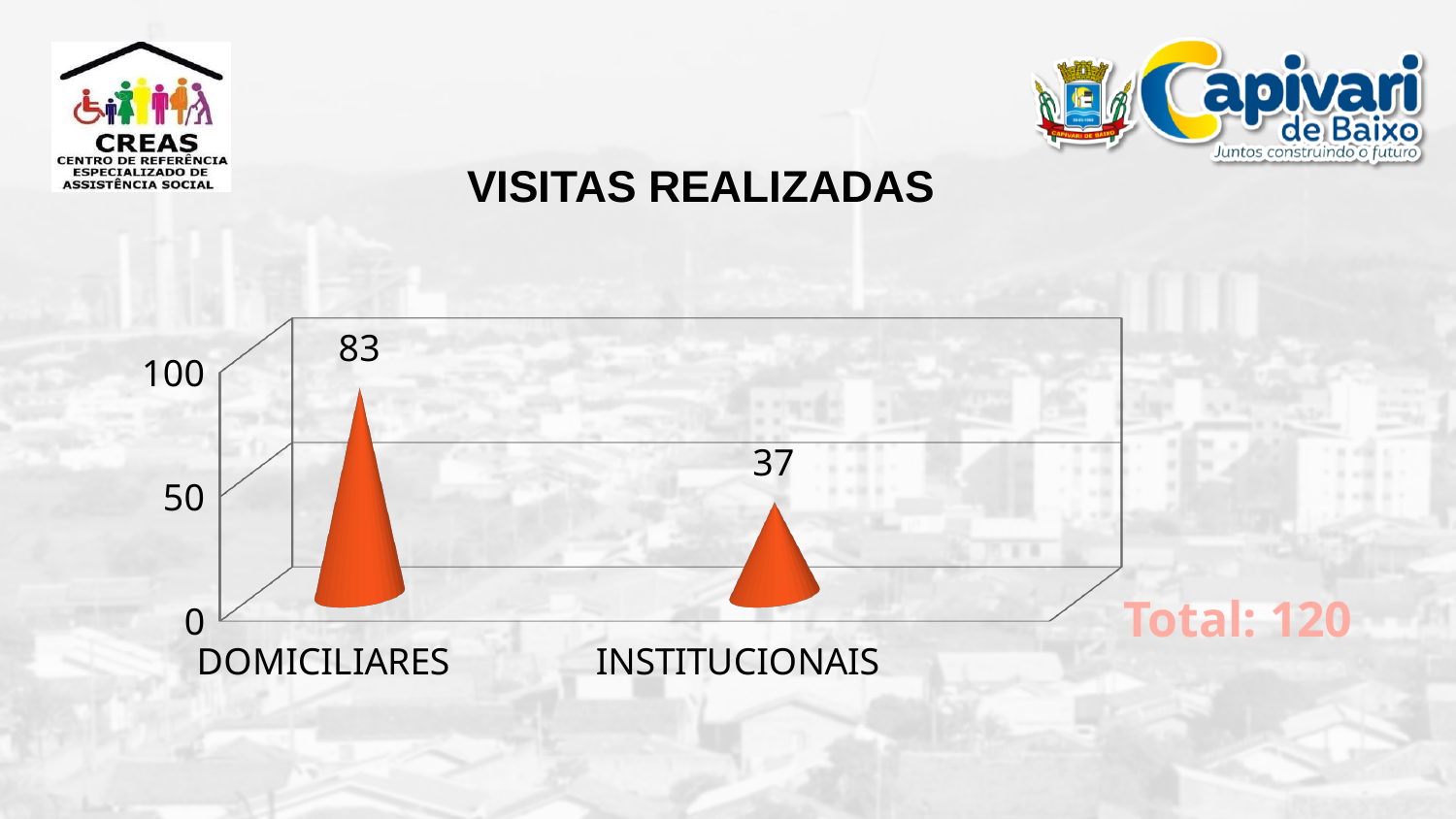
What is the title of the chart? VISITAS REALIZADAS What is the value for INSTITUCIONAIS? 37 What is the difference between the values for DOMICILIARES and INSTITUCIONAIS? 46 Is the value for DOMICILIARES greater or less than 50? greater Which category has the highest value? DOMICILIARES Is the value for INSTITUCIONAIS greater or less than 50? less Which category has the lowest value? INSTITUCIONAIS Which is larger, the value for DOMICILIARES or the value for INSTITUCIONAIS? DOMICILIARES How many categories are shown in the chart? 2 What is the value for DOMICILIARES? 83 What kind of chart is shown on the slide? bar chart What total is printed next to the chart? Total: 120